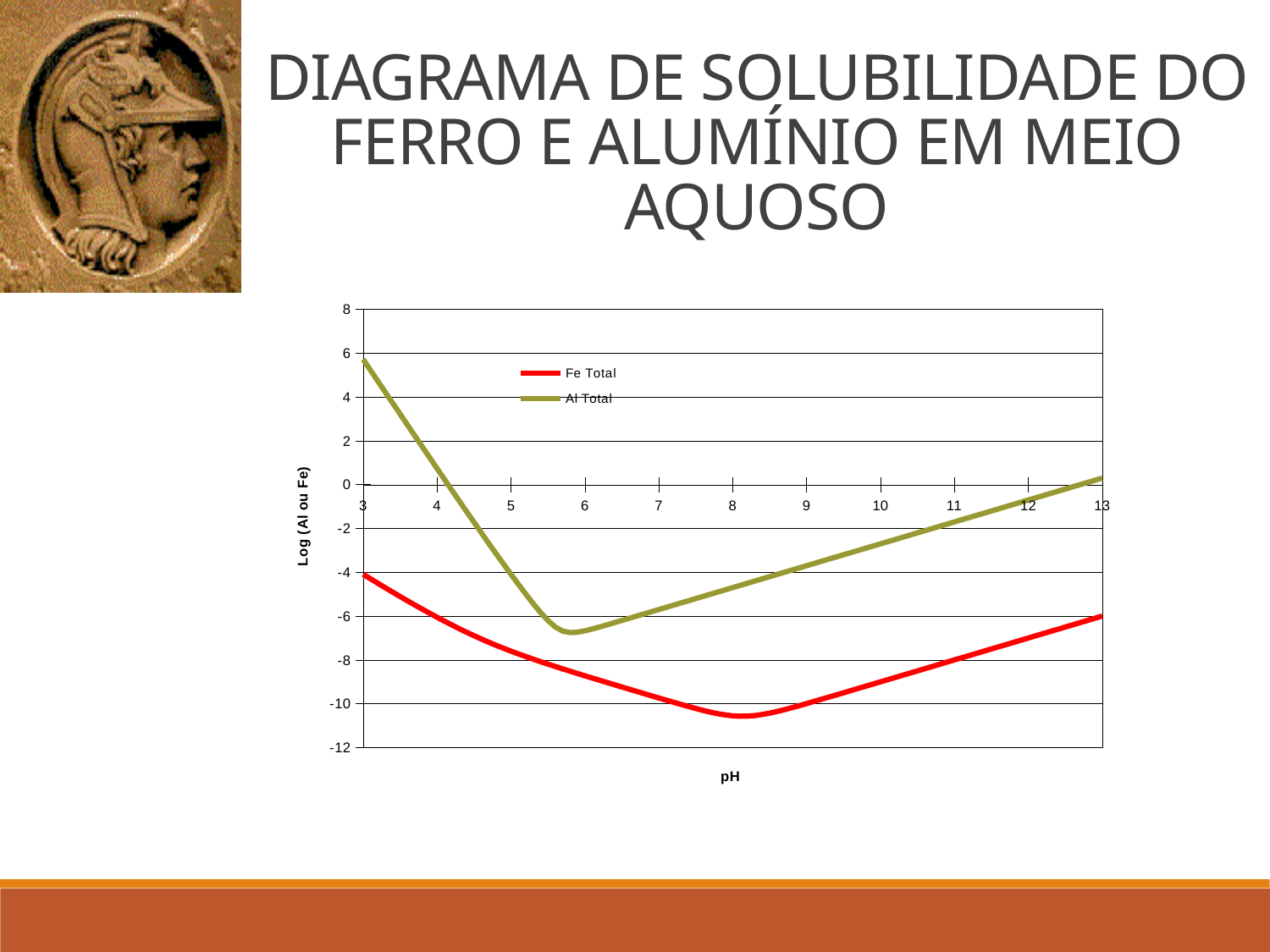
Is the value of Fe Total at pH 13 greater or less than -4? less Is the value of Al Total at pH 10 greater or less than -6? greater How many series does the chart legend list? 2 What kind of chart is shown on the slide? line chart Is the value of Al Total at pH 3 greater or less than 4? greater Does the Fe Total line rise or fall as pH increases from 3 to 8? fall What are the two series named in the chart legend? Fe Total and Al Total Does the Al Total line rise or fall as pH increases from 7 to 13? rise What is the label of the x axis of the chart? pH At pH 8, which series has the larger value, Fe Total or Al Total? Al Total